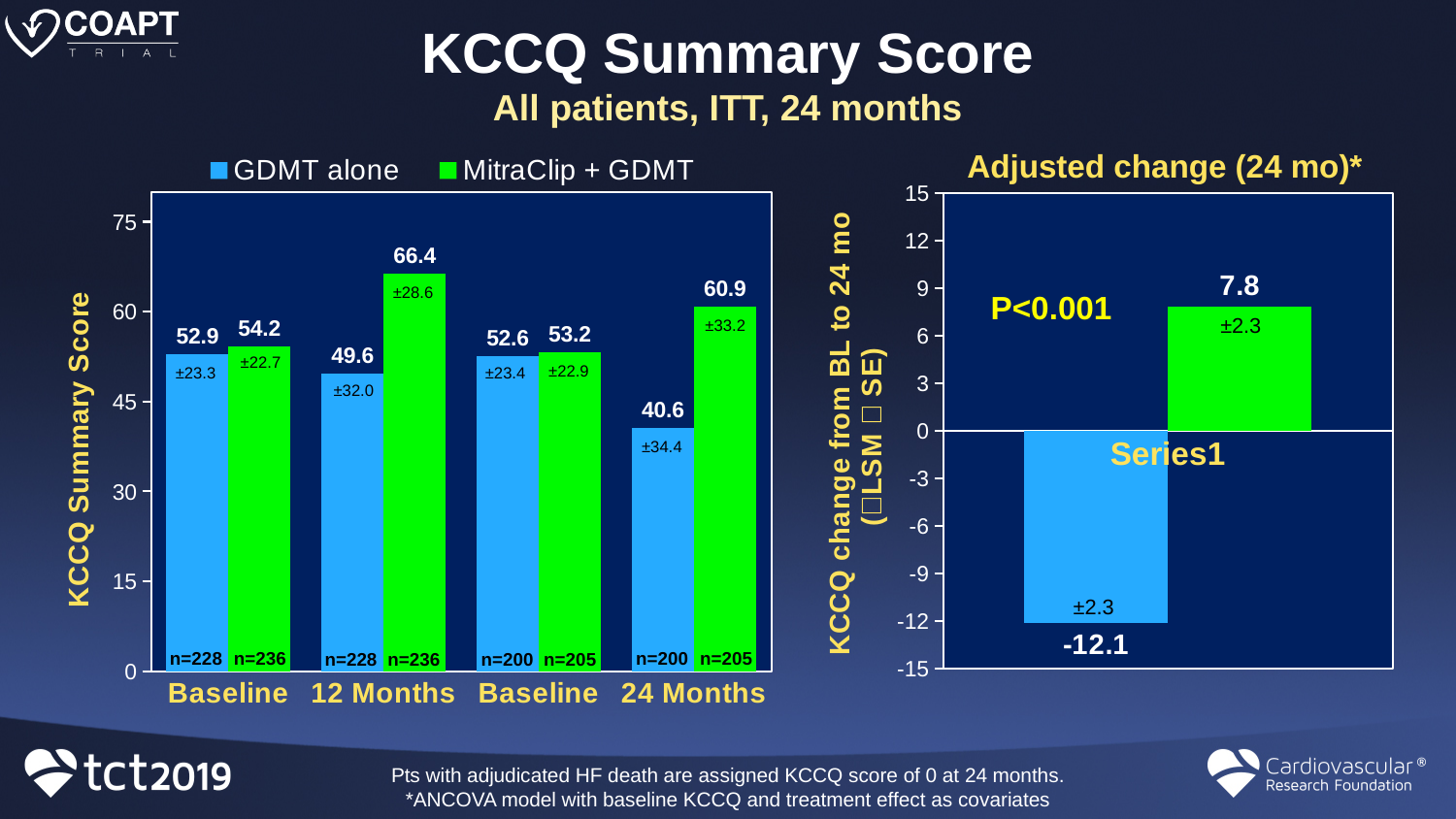
In the left KCCQ Summary Score chart, what is the value for GDMT alone at 24 Months? 40.6 In the left KCCQ Summary Score chart, what is the value for GDMT alone at the first Baseline? 52.9 In the left KCCQ Summary Score chart, which is larger at 12 Months: GDMT alone or MitraClip + GDMT? MitraClip + GDMT What type of chart is the Adjusted change (24 mo)* chart? Bar chart In the left KCCQ Summary Score chart, which bar has the highest value? MitraClip + GDMT at 12 Months How many series does the legend of the left KCCQ Summary Score chart list? 2 In the Adjusted change (24 mo)* chart, what is the value of the green bar? 7.8 In the left KCCQ Summary Score chart, what is the difference between MitraClip + GDMT and GDMT alone at 24 Months? 20.3 How many x-axis categories does the left KCCQ Summary Score chart show? 4 In the Adjusted change (24 mo)* chart, what is the value of the blue bar? -12.1 In the left KCCQ Summary Score chart, what is the value for MitraClip + GDMT at 12 Months? 66.4 In the left KCCQ Summary Score chart, which bar has the lowest value? GDMT alone at 24 Months